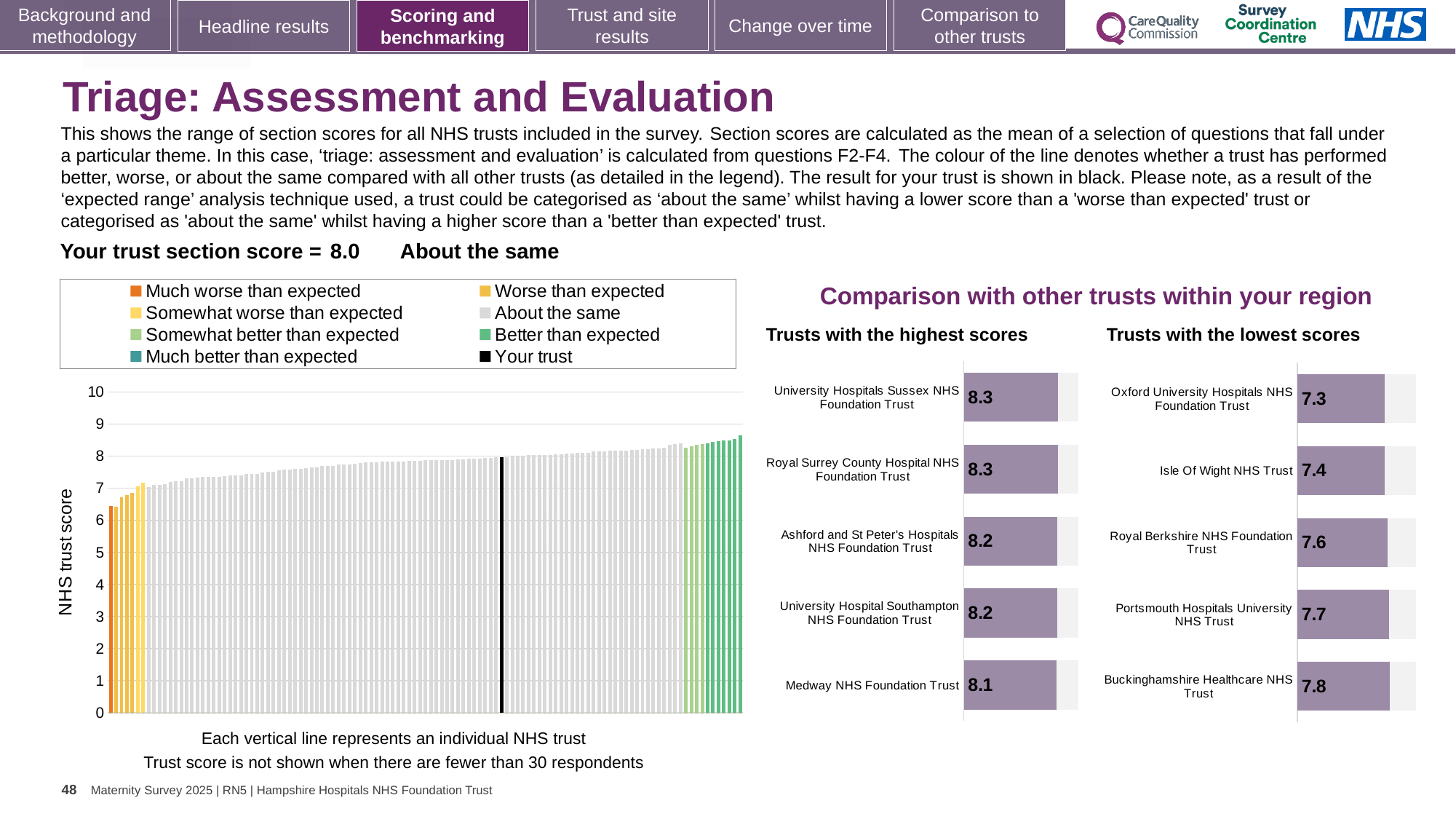
How many trusts are shown in the 'Trusts with the highest scores' chart? 5 In the main 'NHS trust score' chart on the left, do the values rise or fall from left to right? Rise In the 'Trusts with the lowest scores' chart, which trust has the highest score? Buckinghamshire Healthcare NHS Trust In the 'Trusts with the lowest scores' chart, what is the score for Oxford University Hospitals NHS Foundation Trust? 7.3 What is the y-axis label of the main chart on the left? NHS trust score How many entries does the legend of the main 'NHS trust score' chart on the left list? 8 In the 'Trusts with the lowest scores' chart, which trust has the lowest score? Oxford University Hospitals NHS Foundation Trust What kind of chart is the main chart on the left showing NHS trust scores? Bar chart In the main 'NHS trust score' chart on the left, is the value of the leftmost (lowest) bar greater or less than 7? less In the 'Trusts with the lowest scores' chart, which has the larger score: Royal Berkshire NHS Foundation Trust or Portsmouth Hospitals University NHS Trust? Portsmouth Hospitals University NHS Trust In the 'Trusts with the highest scores' chart, what is the score for Medway NHS Foundation Trust? 8.1 In the 'Trusts with the highest scores' chart, what is the difference between the score for University Hospitals Sussex NHS Foundation Trust and the score for Medway NHS Foundation Trust? 0.2